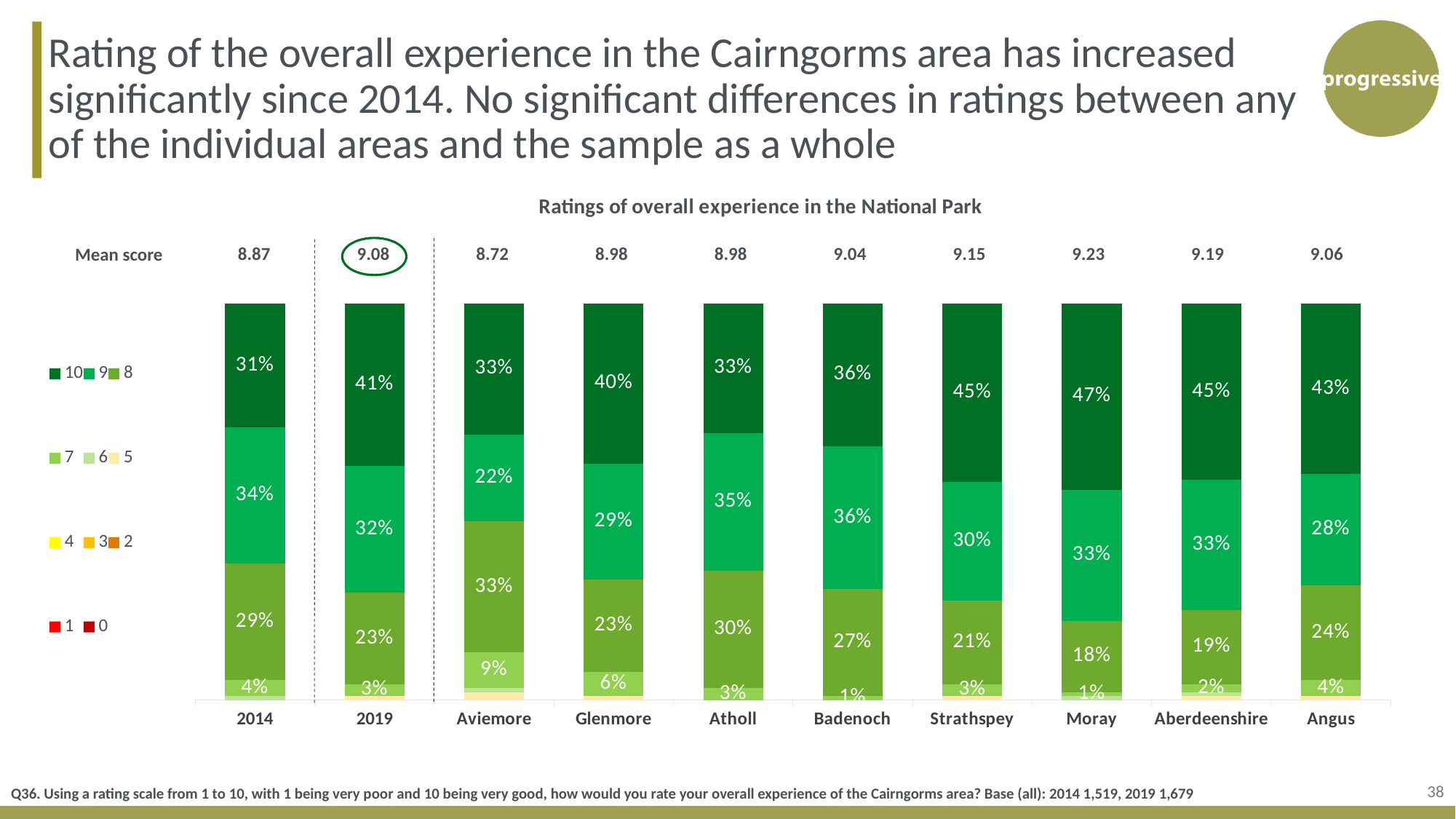
What percentage of respondents rated their overall experience 10 in 2019? 41% Which has a larger share of respondents rating 9: Atholl or Aviemore? Atholl How many bars (years and areas) are shown on the x axis? 10 Which area or year has the lowest mean score? Aviemore What is the title of the chart? Ratings of overall experience in the National Park What is the difference between the percentage rating 10 in 2019 and in 2014? 10 percentage points Which mean score is circled on the chart? 9.08 What is the mean score shown for Moray? 9.23 Which area or year has the highest percentage of respondents rating their experience 10? Moray What kind of chart is shown on the slide? Stacked bar chart How many rating categories does the legend list? 11 What percentage of respondents in Aviemore gave a rating of 8? 33%